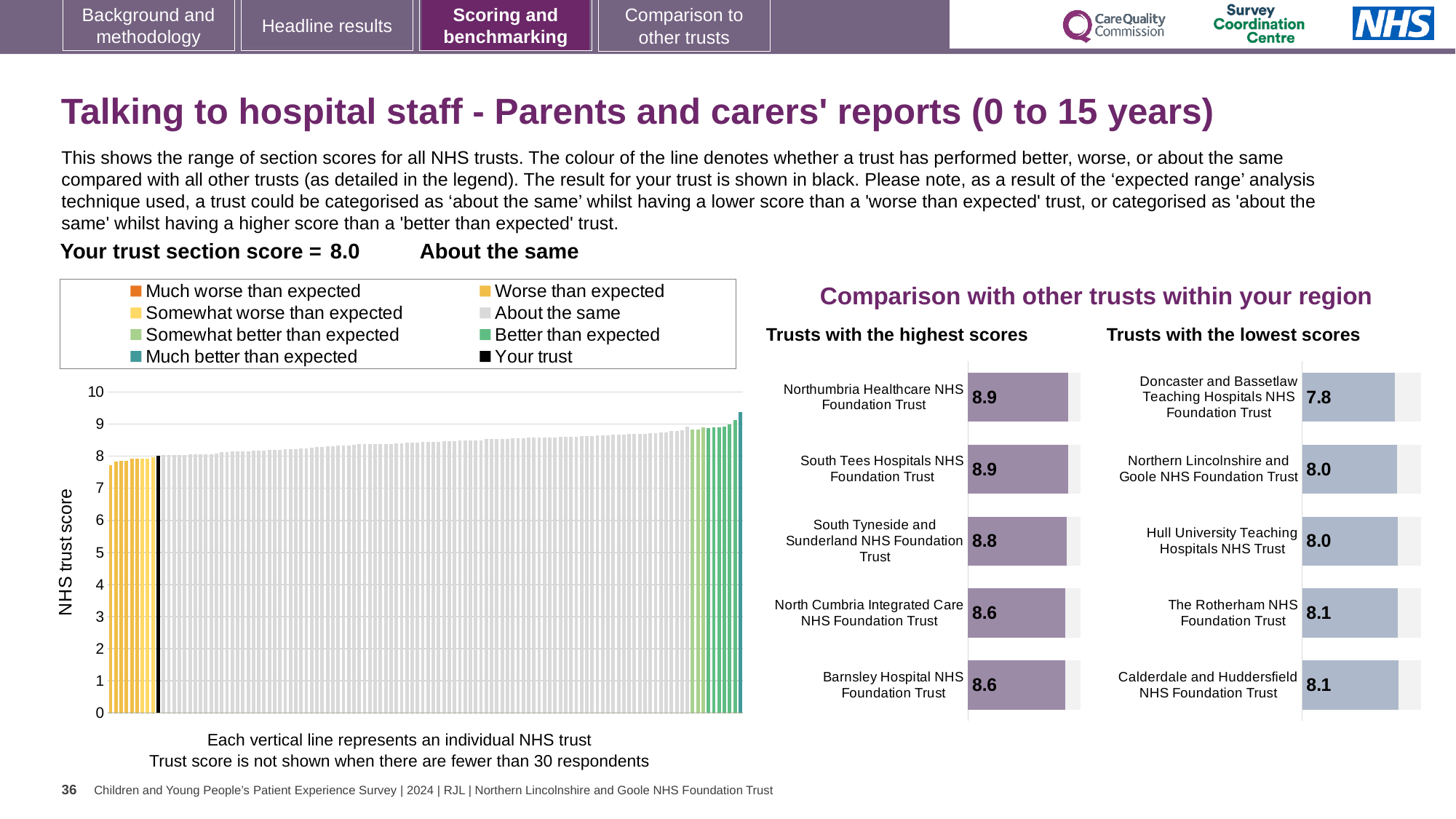
In the 'Trusts with the lowest scores' chart, what is the score for Doncaster and Bassetlaw Teaching Hospitals NHS Foundation Trust? 7.8 In the 'Trusts with the lowest scores' chart, what is the difference between the scores of The Rotherham NHS Foundation Trust and Doncaster and Bassetlaw Teaching Hospitals NHS Foundation Trust? 0.3 What kind of chart is the main chart on the left showing NHS trust scores? Bar chart In the 'Trusts with the highest scores' chart, which has the higher score: South Tyneside and Sunderland NHS Foundation Trust or North Cumbria Integrated Care NHS Foundation Trust? South Tyneside and Sunderland NHS Foundation Trust In the main chart on the left, do the trust scores rise or fall from left to right? Rise How many trusts are listed in the 'Trusts with the highest scores' chart? 5 In the main chart on the left, is the value of the tallest bar greater or less than 9? greater In the 'Trusts with the highest scores' chart, what is the score for Northumbria Healthcare NHS Foundation Trust? 8.9 What is the y-axis title of the main chart on the left? NHS trust score How many entries does the legend of the main NHS trust score chart on the left list? 8 In the 'Trusts with the highest scores' chart, what is the difference between the scores of South Tyneside and Sunderland NHS Foundation Trust and Barnsley Hospital NHS Foundation Trust? 0.2 In the 'Trusts with the lowest scores' chart, which trust has the lowest score? Doncaster and Bassetlaw Teaching Hospitals NHS Foundation Trust